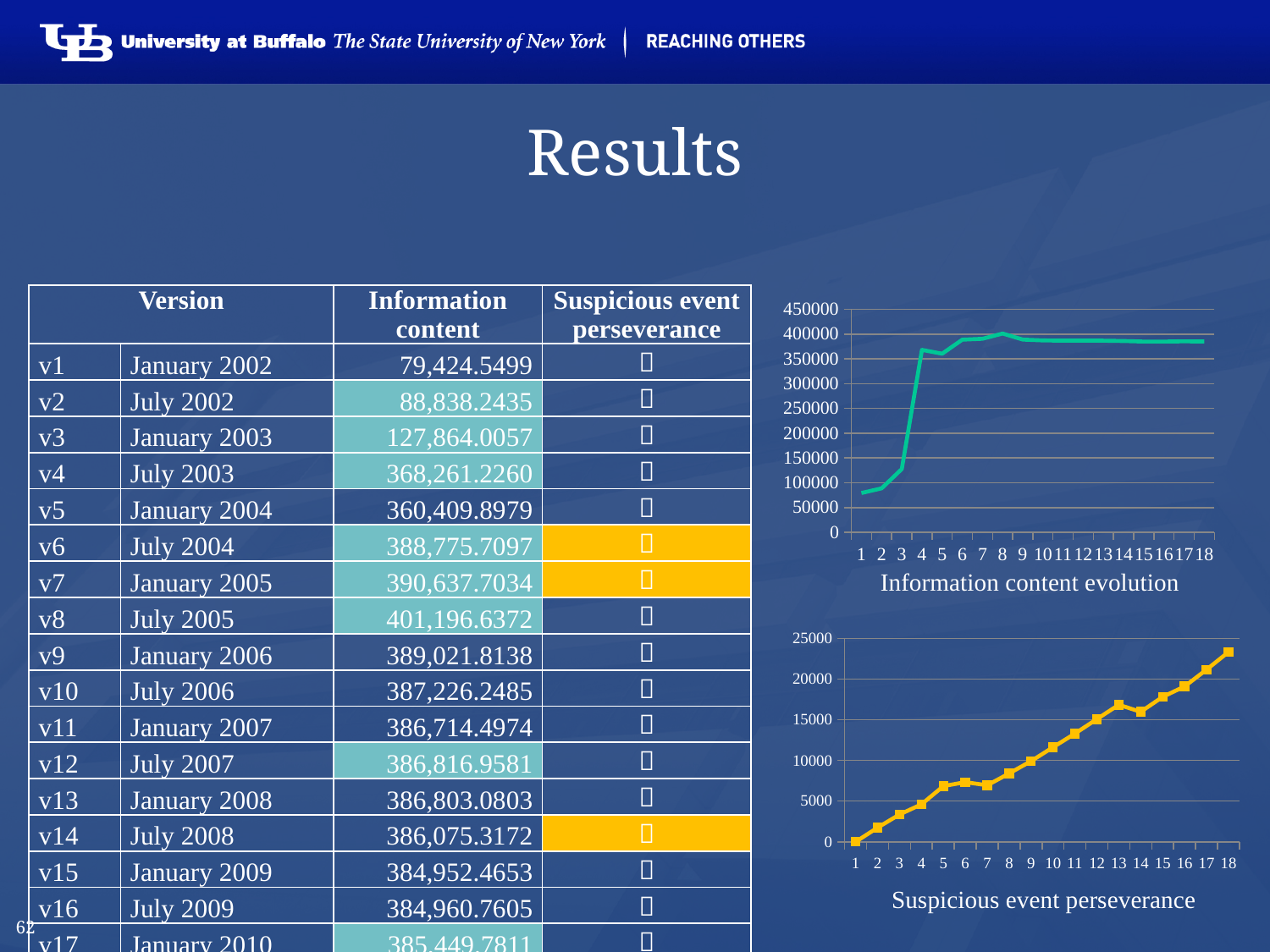
In the 'Suspicious event perseverance' chart, is the value at point 18 greater or less than 20000? greater In the 'Information content evolution' chart, is the value at point 3 greater or less than 200000? less In the 'Suspicious event perseverance' chart, which x-axis point has the highest value? 18 What kind of chart is the 'Suspicious event perseverance' chart? line chart In the 'Suspicious event perseverance' chart, do the values generally rise or fall from point 1 to point 18? rise In the 'Information content evolution' chart, is the value at point 1 greater or less than 100000? less What is the title of the lower chart on the slide? Suspicious event perseverance What kind of chart is the 'Information content evolution' chart? line chart In the 'Information content evolution' chart, how many points are plotted along the x axis? 18 In the 'Suspicious event perseverance' chart, how many points are plotted along the x axis? 18 In the 'Information content evolution' chart, which x-axis point has the lowest value? 1